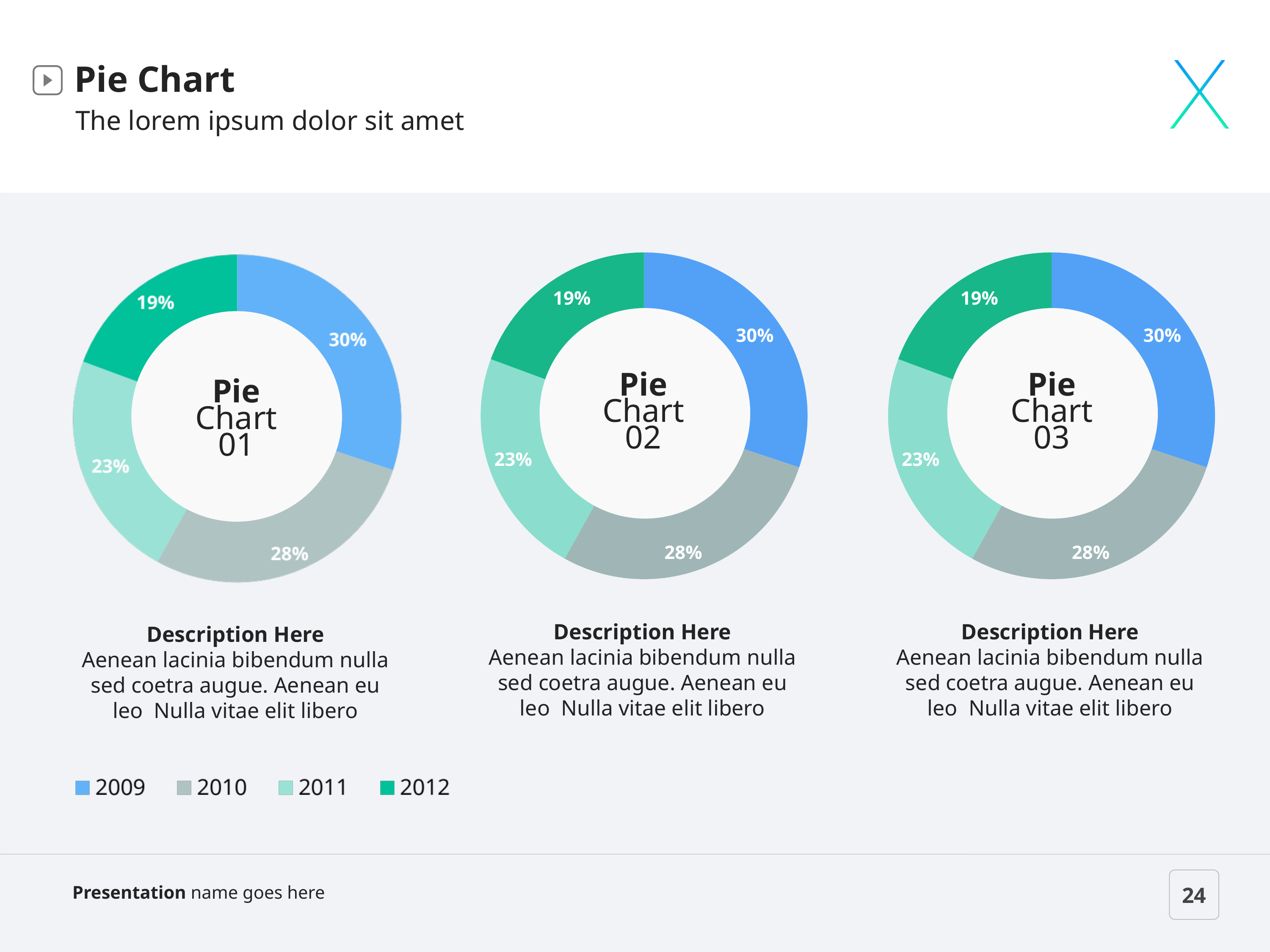
In Pie Chart 02, which year has the largest share? 2009 In Pie Chart 03, which year has the smallest share? 2012 In Pie Chart 01, what is the value for 2009? 30% In Pie Chart 02, what is the value for 2011? 23% In Pie Chart 01, what is the value for 2010? 28% In Pie Chart 02, which is larger, the share for 2010 or the share for 2011? 2010 Which colour represents 2012 in the legend? Green How many slices does Pie Chart 03 have? 4 How many entries does the legend at the bottom of the slide list? 4 What kind of chart is Pie Chart 01? Pie chart In Pie Chart 03, what is the value for 2012? 19% In Pie Chart 01, what is the difference between the shares for 2009 and 2012? 11%